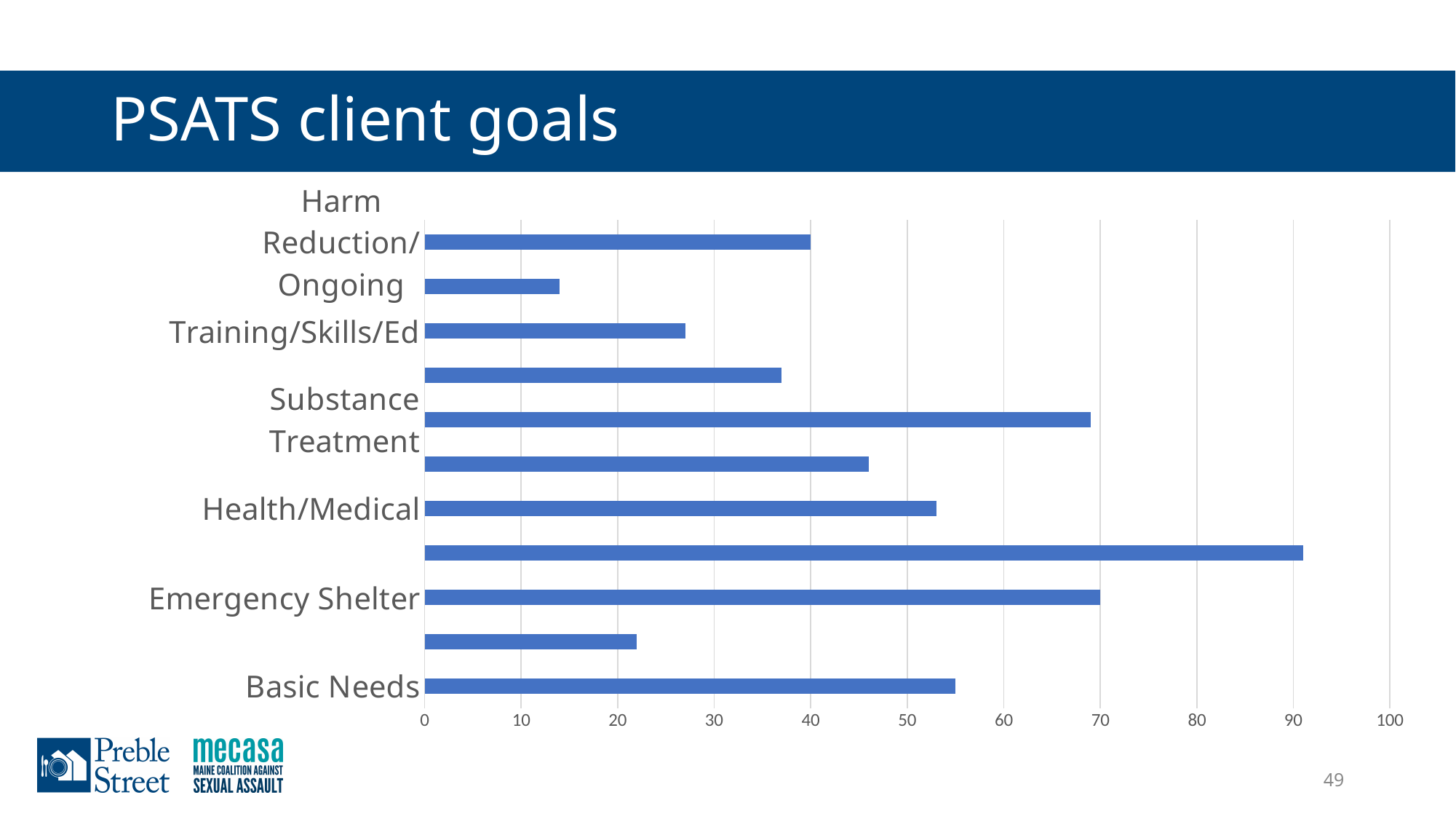
Is the value for Training/Skills/Ed greater or less than 30? less How many bars are plotted in the chart? 11 What is the title of the slide containing the chart? PSATS client goals What is the maximum value shown on the horizontal axis? 100 Which has the larger value, Harm Reduction/Ongoing or Training/Skills/Ed? Harm Reduction/Ongoing Which has the larger value, Emergency Shelter or Basic Needs? Emergency Shelter Is the value for Harm Reduction/Ongoing greater or less than 50? less Is the value for Substance Treatment greater or less than 60? greater Which has the larger value, Substance Treatment or Health/Medical? Substance Treatment What kind of chart is shown on the slide? bar chart